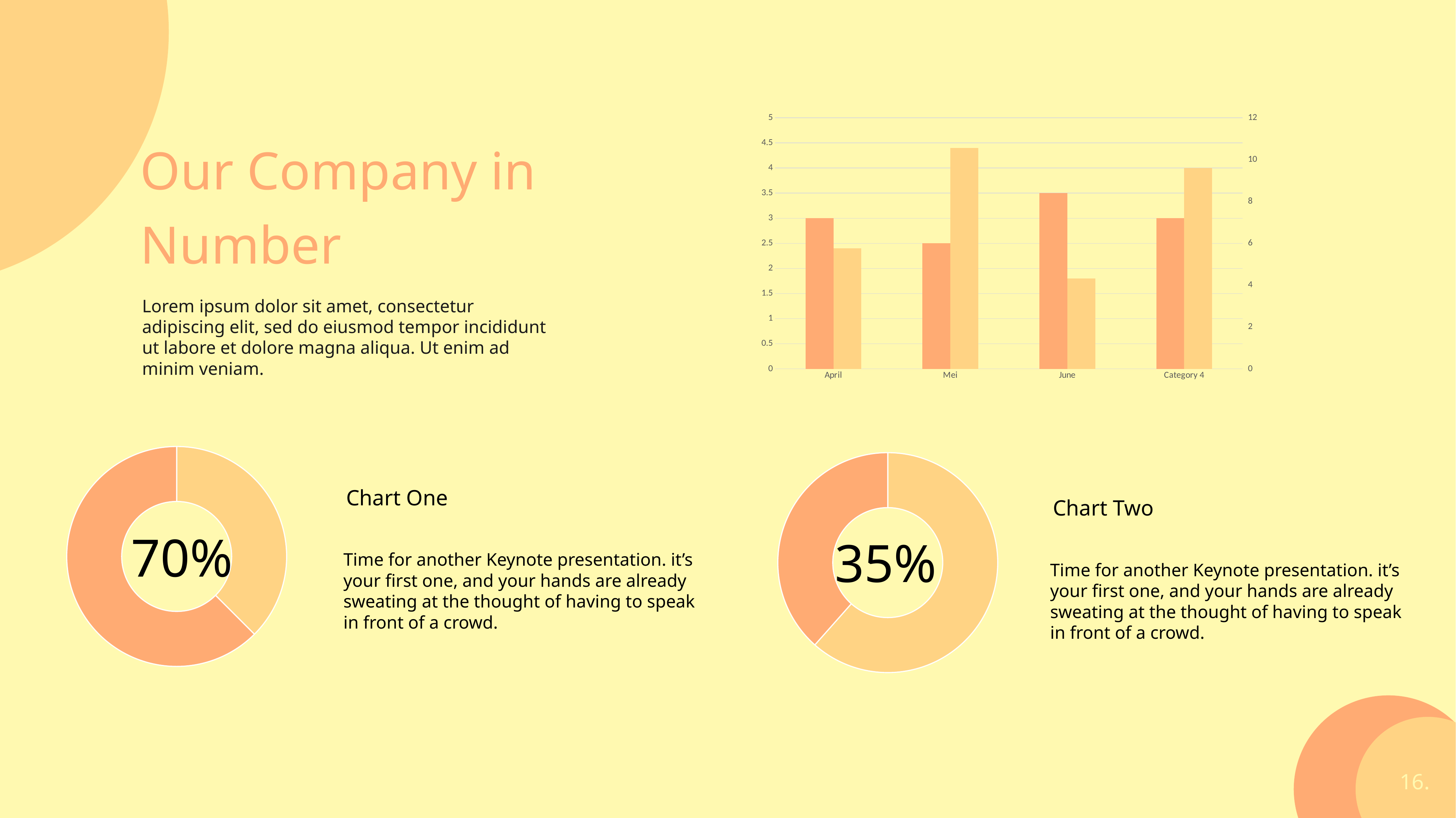
In the bar chart at the top right, which category has the shortest light orange bar? June What percentage is shown in the centre of the donut chart labelled Chart Two? 35% In the bar chart at the top right, for Mei, which bar is taller: the dark orange bar or the light orange bar? light orange What kind of chart is shown at the top right of the slide? bar chart What percentage is shown in the centre of the donut chart labelled Chart One? 70% In the bar chart at the top right, which category has the tallest light orange bar? Mei In the bar chart at the top right, which category has the shortest dark orange bar? Mei In the bar chart at the top right, how many categories are shown on the x axis? 4 In the bar chart at the top right, which category has the tallest dark orange bar? June In the bar chart at the top right, reading the left axis, is the dark orange bar for June greater or less than 3? greater In the bar chart at the top right, reading the left axis, what is the value of the dark orange bar for April? 3 In the bar chart at the top right, for April, which bar is taller: the dark orange bar or the light orange bar? dark orange